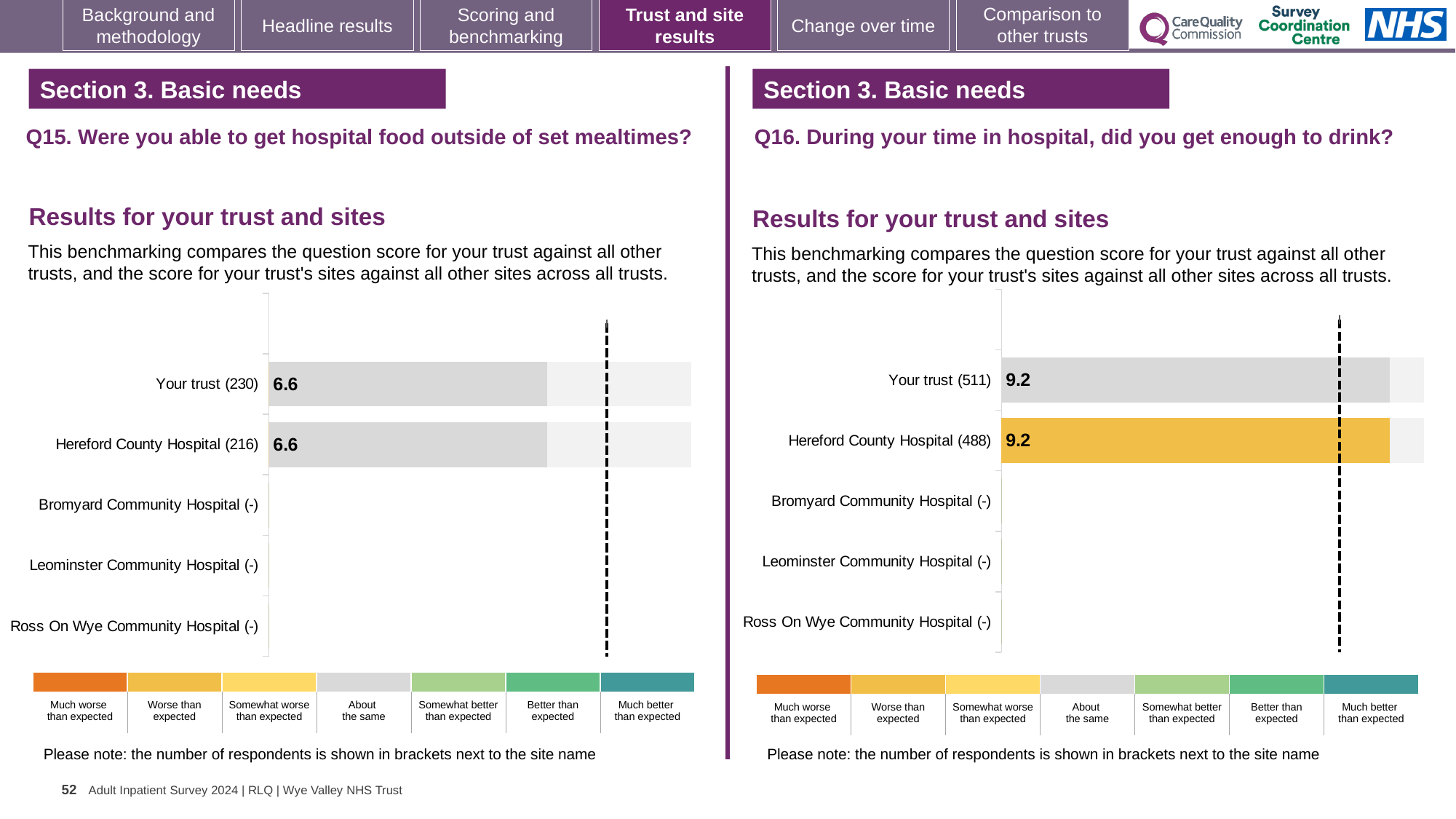
In the Q15 chart, what is the score for Your trust (230)? 6.6 How many sites or categories are listed on the y axis of the Q16 chart? 5 In the Q16 chart, what is the score for Your trust (511)? 9.2 Which is larger: the Hereford County Hospital score in the Q15 chart or in the Q16 chart? Q16 chart How many benchmark categories does the colour legend below the Q15 chart list? 7 What kind of chart is used for the Q15 results? Bar chart In the Q16 chart, what is the score for Hereford County Hospital (488)? 9.2 What is the difference between the Your trust score in the Q16 chart and the Your trust score in the Q15 chart? 2.6 In the Q15 chart, how many sites have a plotted bar? 2 In the Q16 chart, how many respondents are shown in brackets for Hereford County Hospital? 488 How many sites or categories are listed on the y axis of the Q15 chart? 5 In the Q15 chart, what is the score for Hereford County Hospital (216)? 6.6